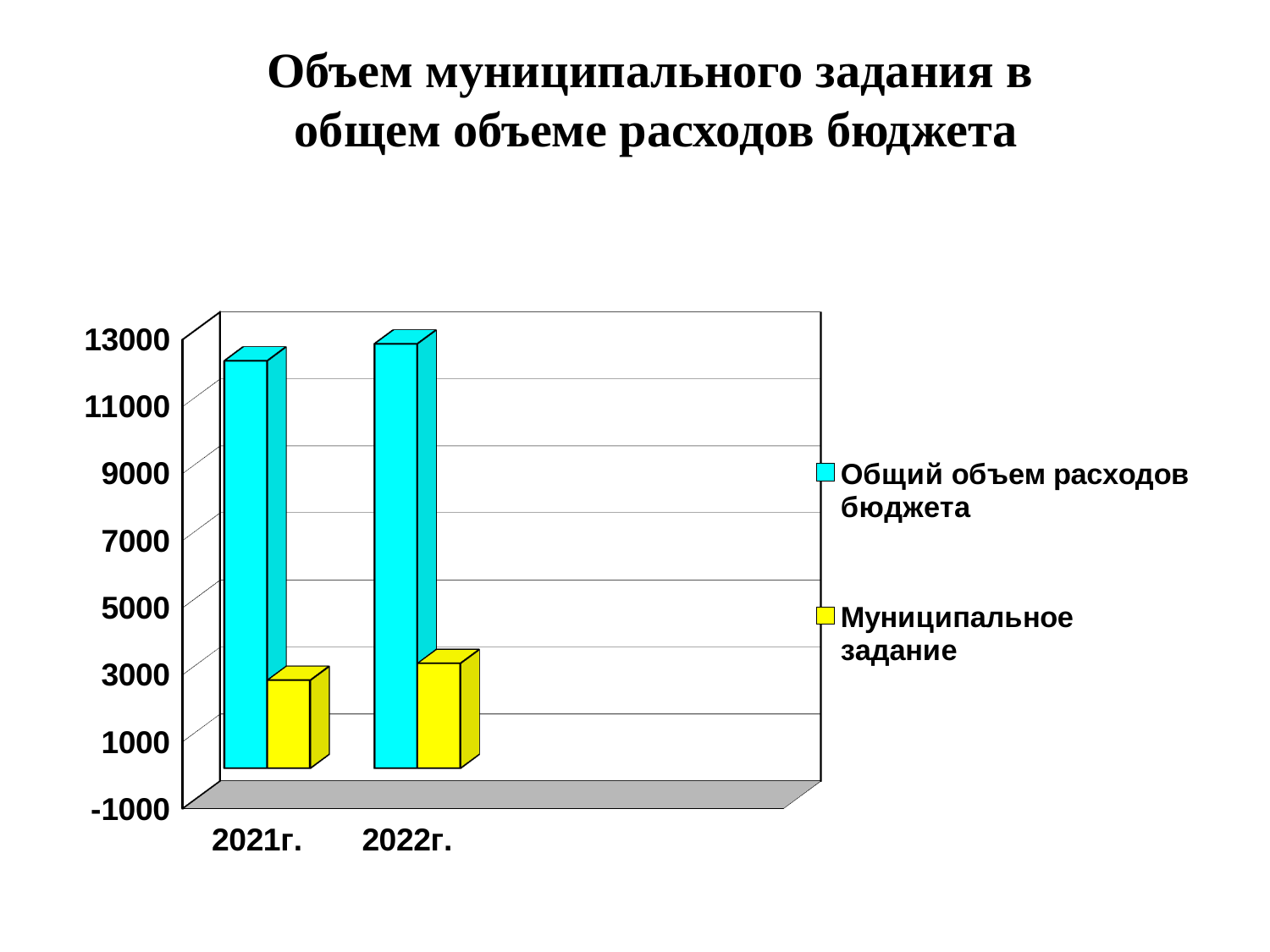
What colour are the bars for "Муниципальное задание"? yellow Is the value for "Муниципальное задание" in 2022г. greater or less than 1000? greater Do the values for "Муниципальное задание" rise or fall from 2021г. to 2022г.? rise Is the value for "Общий объем расходов бюджета" in 2022г. greater or less than 11000? greater Which series has the larger value in 2021г., "Общий объем расходов бюджета" or "Муниципальное задание"? Общий объем расходов бюджета Is the value for "Муниципальное задание" in 2021г. greater or less than 5000? less What is the title of the chart? Объем муниципального задания в общем объеме расходов бюджета How many series does the legend list? 2 Which year has the larger value for "Муниципальное задание", 2021г. or 2022г.? 2022г. How many categories (years) are shown on the x axis? 2 What kind of chart is shown on the slide? bar chart